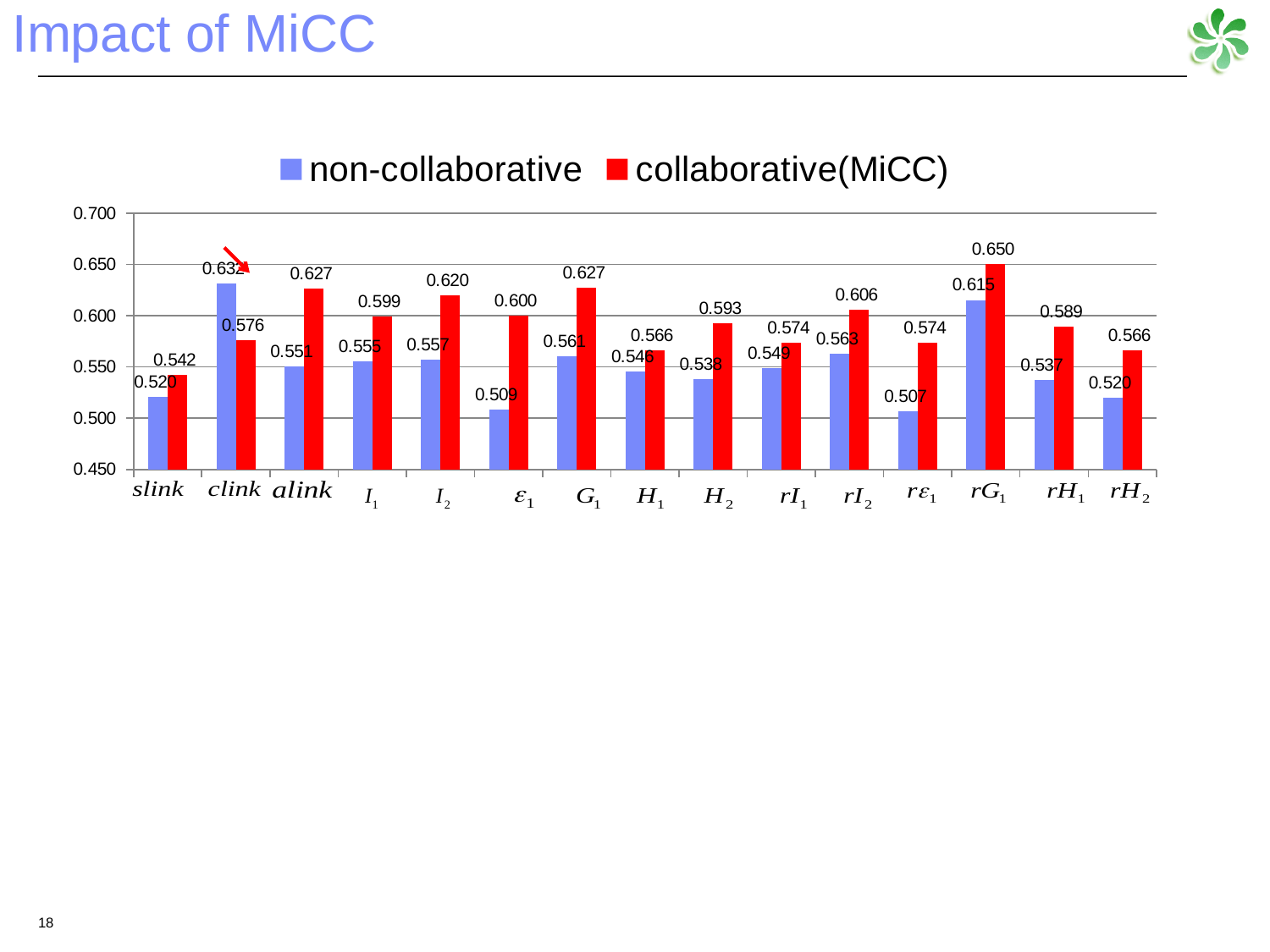
For clink, which is larger: the non-collaborative value or the collaborative(MiCC) value? non-collaborative Which category has the lowest collaborative(MiCC) value? slink How many categories are shown on the x axis? 15 What kind of chart is shown on the slide? bar chart What is the difference between the collaborative(MiCC) and non-collaborative values for ε1? 0.091 What is the collaborative(MiCC) value for ε1? 0.600 What is the difference between the collaborative(MiCC) and non-collaborative values for rG1? 0.035 What is the collaborative(MiCC) value for rG1? 0.650 What is the non-collaborative value for clink? 0.632 How many series does the legend list? 2 Which category has the highest non-collaborative value? clink Which category has the highest collaborative(MiCC) value? rG1